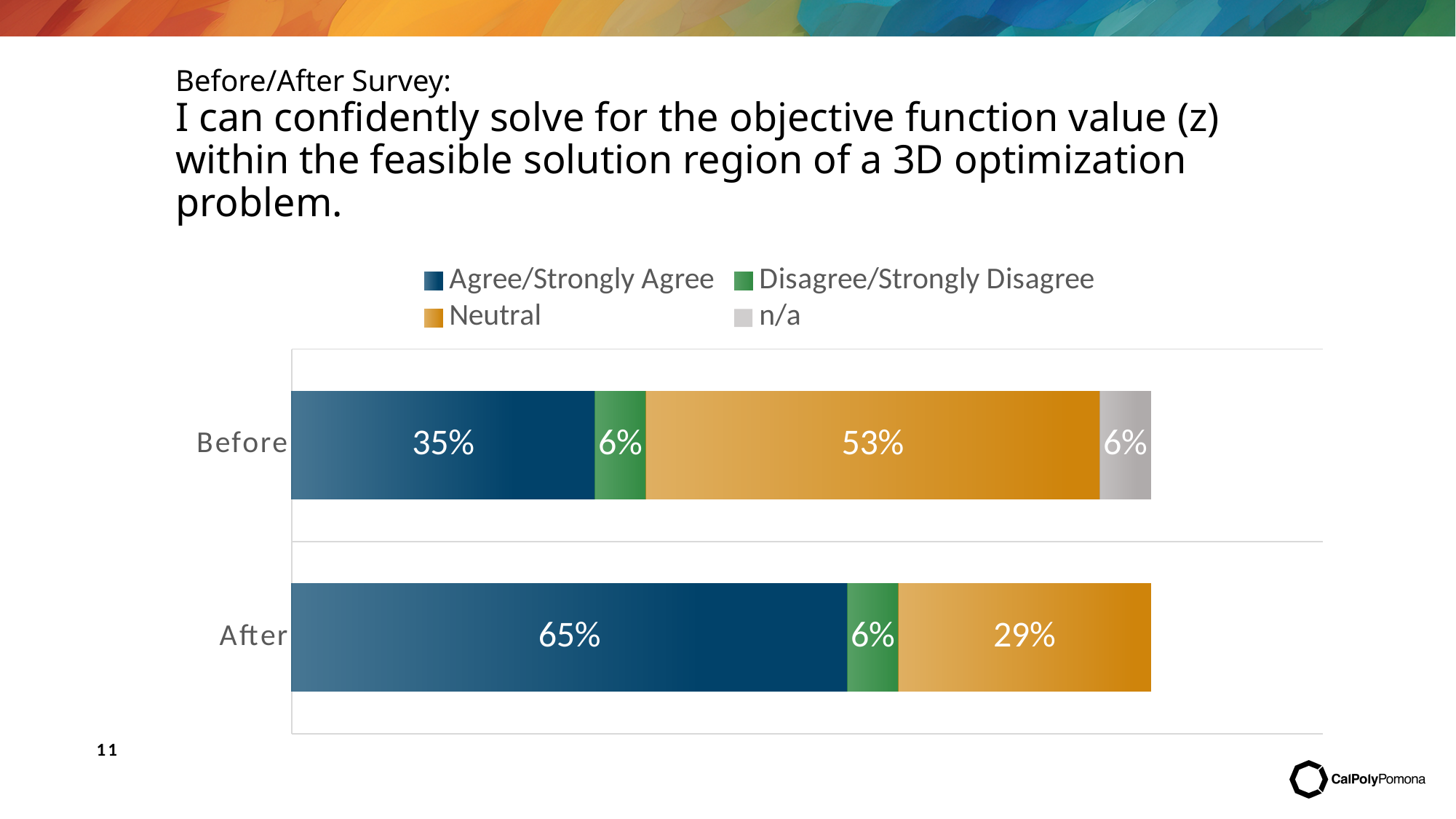
How many series does the legend list? 4 What is the n/a value for Before? 6% What is the Disagree/Strongly Disagree value for After? 6% What is the Neutral value for Before? 53% What is the Agree/Strongly Agree value for After? 65% What is the Neutral value for After? 29% How many categories (bars) are shown in the chart? 2 By how many percentage points did the Agree/Strongly Agree share increase from Before to After? 30% Which series is shown in green in the legend? Disagree/Strongly Disagree What kind of chart is shown on the slide? Stacked bar chart Which is larger, the Neutral value for Before or the Neutral value for After? Before What is the Agree/Strongly Agree value for Before? 35%